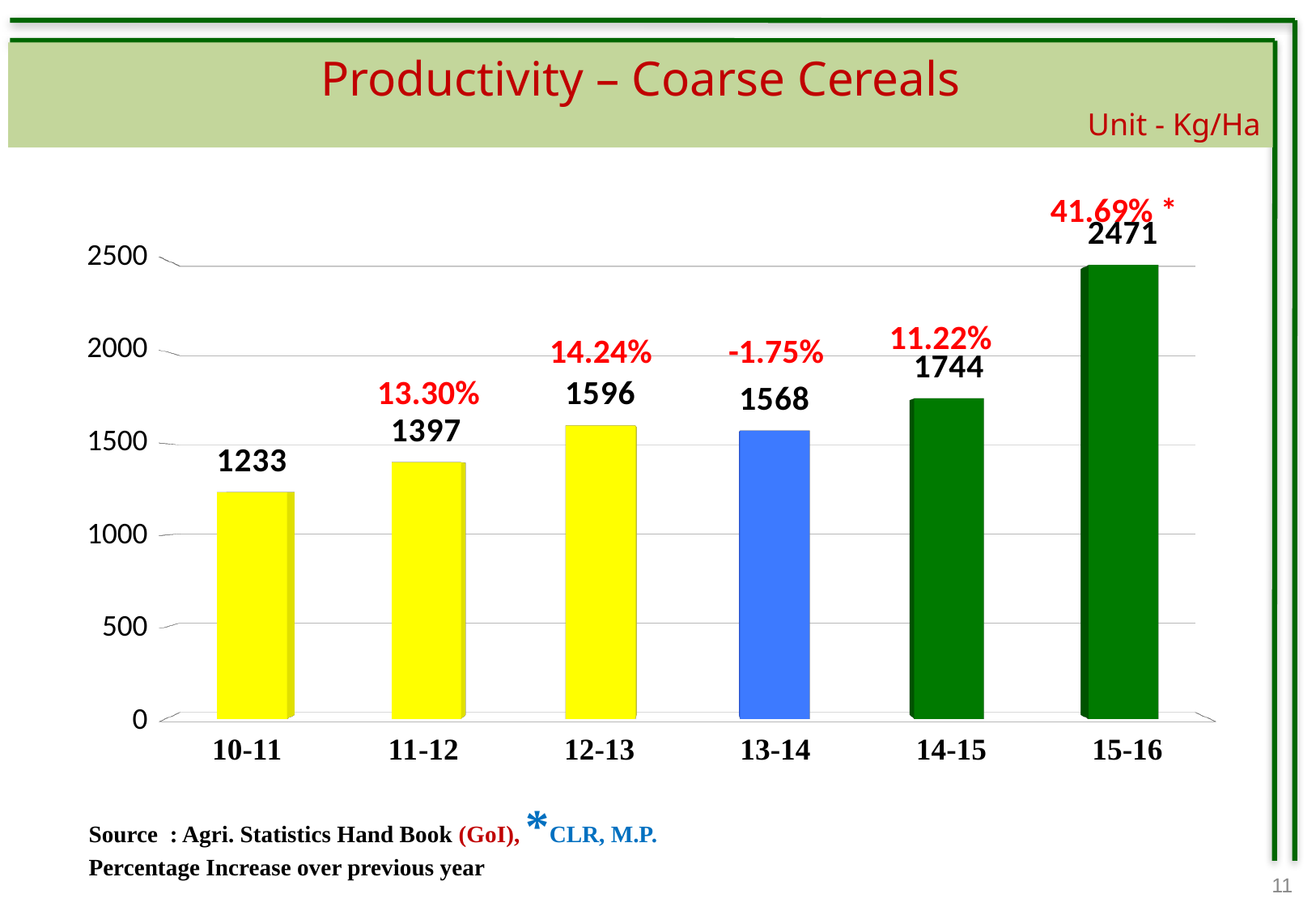
What kind of chart is shown on the slide? bar chart What percentage increase over the previous year is shown for 15-16? 41.69% Is the value for 11-12 greater or less than 1500? less What is the productivity value for 13-14? 1568 What is the difference in productivity between 15-16 and 14-15? 727 Which year has the lowest productivity? 10-11 Which is larger, the productivity for 12-13 or for 13-14? 12-13 How many years are shown on the x axis? 6 What unit is stated for the chart values? Kg/Ha Which year shows a negative percentage change over the previous year? 13-14 What is the productivity value for 10-11? 1233 Which year has the highest productivity? 15-16